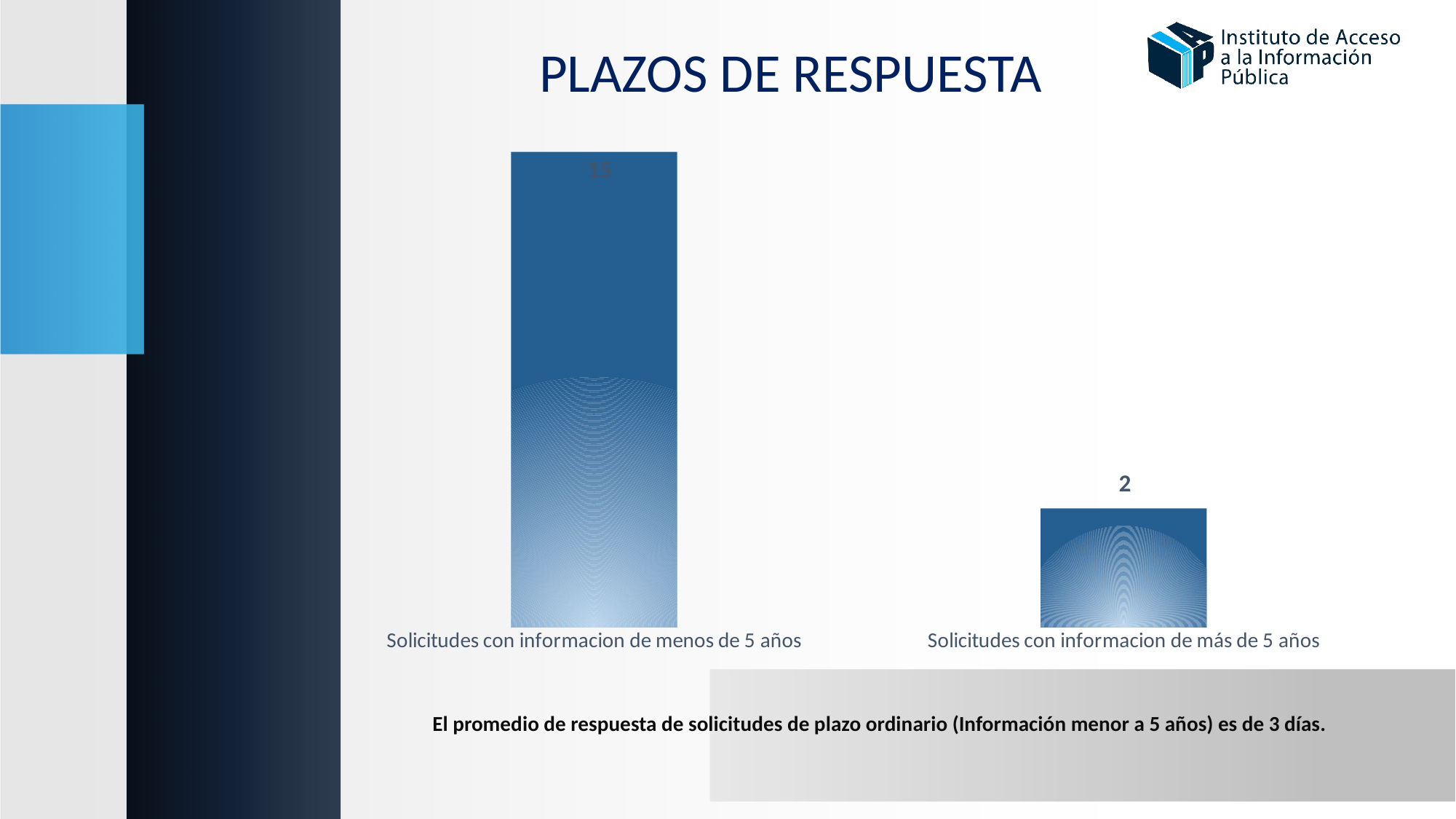
How many categories are shown in the chart? 2 What is the value for 'Solicitudes con informacion de menos de 5 años'? 15 What kind of chart is shown on the slide? Bar chart What is the difference between the value for 'Solicitudes con informacion de menos de 5 años' and 'Solicitudes con informacion de más de 5 años'? 13 What is the title of the slide containing the chart? PLAZOS DE RESPUESTA What is the value for 'Solicitudes con informacion de más de 5 años'? 2 Which category has the highest value? Solicitudes con informacion de menos de 5 años Which category has the lowest value? Solicitudes con informacion de más de 5 años Do the values rise or fall from the left bar to the right bar? Fall Which is larger: the value for 'Solicitudes con informacion de menos de 5 años' or 'Solicitudes con informacion de más de 5 años'? Solicitudes con informacion de menos de 5 años